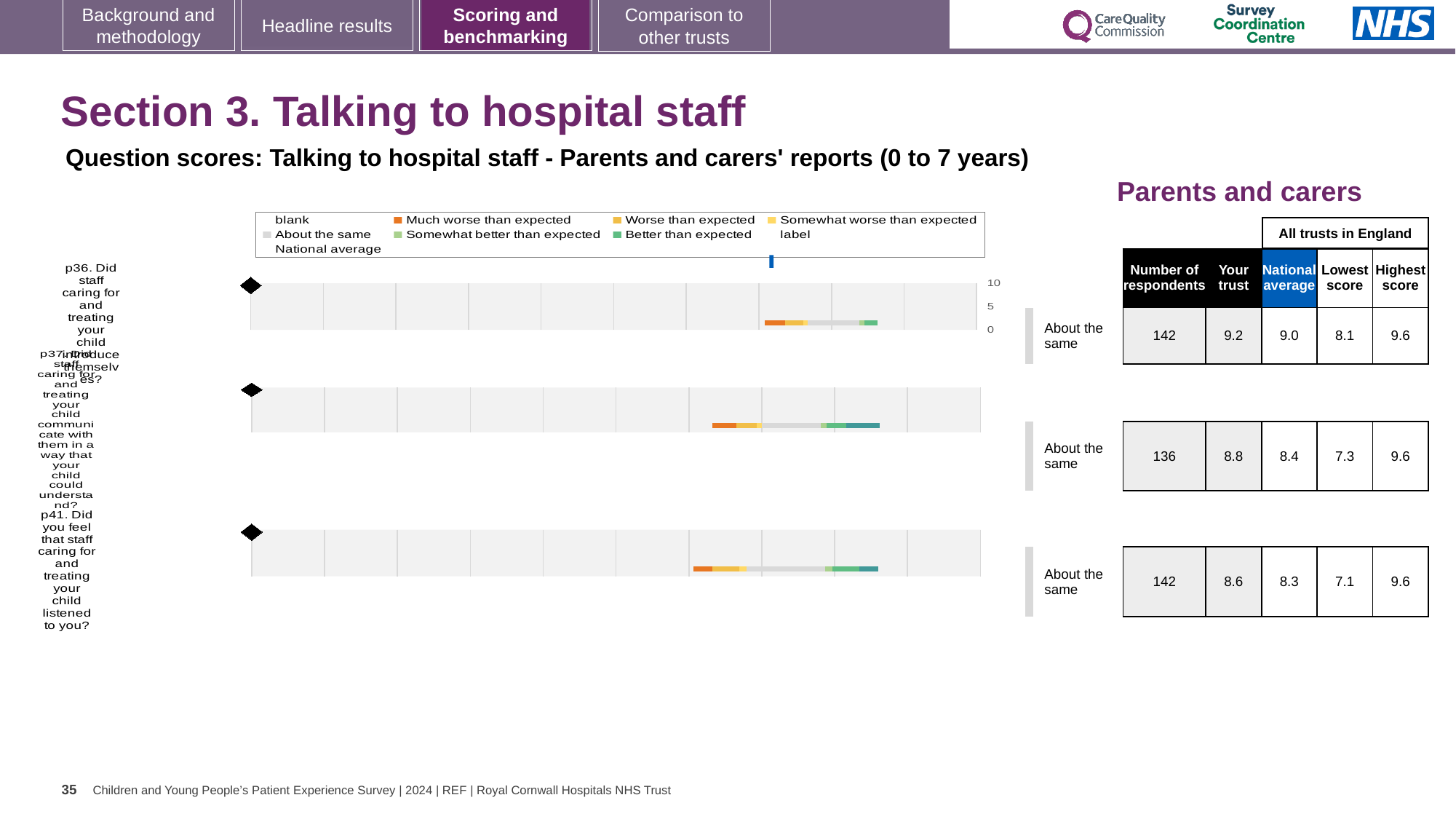
What benchmark category is shown next to each of the three charts? About the same For the p41 chart (Did you feel that staff caring for and treating your child listened to you?), what is the number of respondents? 142 Which of the three questions (p36, p37, p41) has the highest 'Your trust' score? p36 For the p37 chart (Did staff communicate with them in a way that your child could understand?), what is the National average score? 8.4 What kind of chart is used to show the question scores for p36, p37 and p41? Bar chart For the p37 chart, which is larger: the 'Your trust' score or the National average? Your trust How many entries does the chart legend list? 9 For the p36 chart, what is the difference between the 'Your trust' score and the National average? 0.2 Is the 'Your trust' score for p36 greater or less than 5 on the chart axis? greater How many question charts (p36, p37, p41) are shown on the slide? 3 Which of the three questions (p36, p37, p41) has the lowest 'Lowest score' across all trusts in England? p41 For the p36 chart (Did staff caring for and treating your child introduce themselves?), what is the 'Your trust' score? 9.2